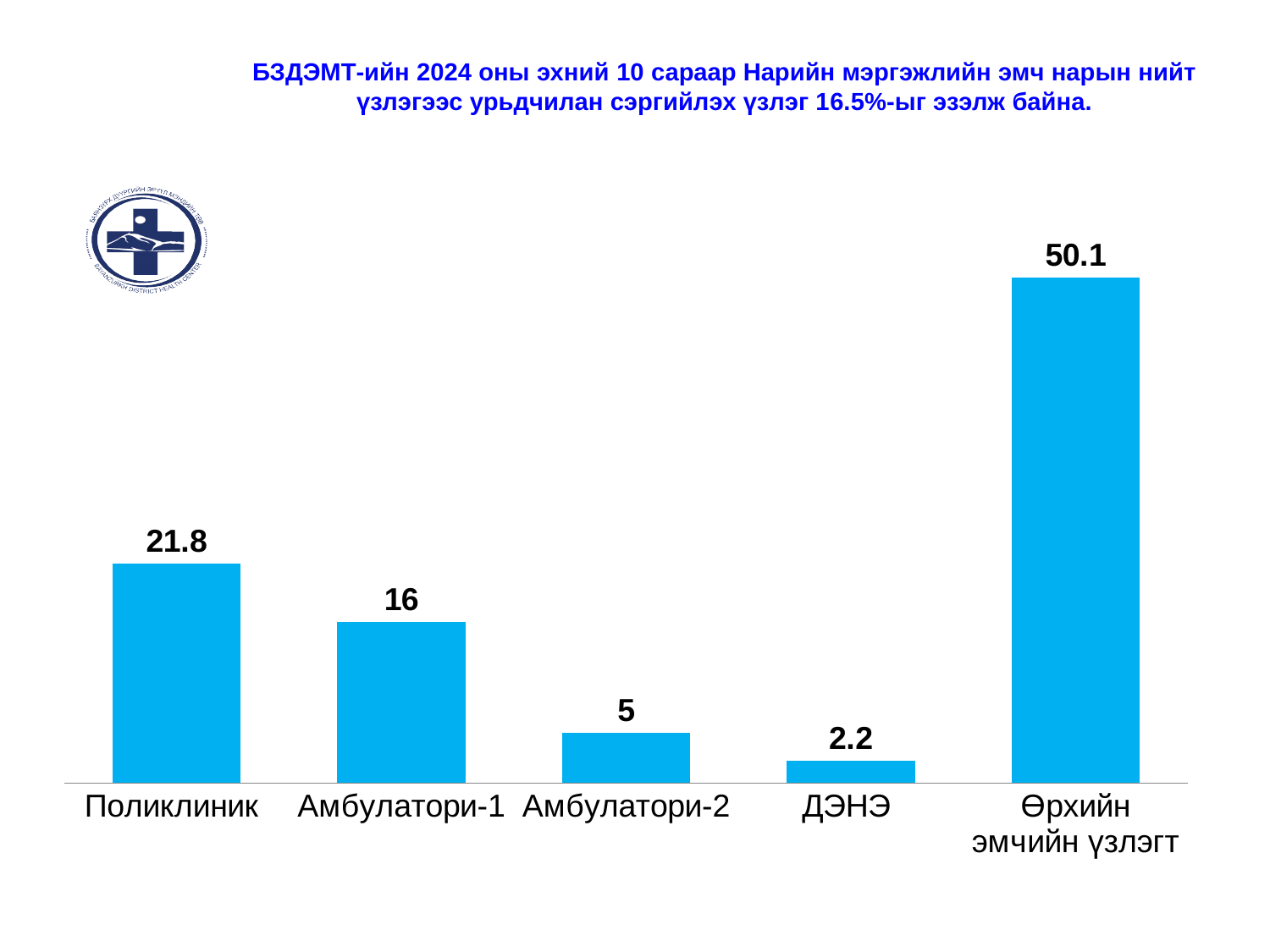
What kind of chart is shown on the slide? Bar chart What is the difference between the values for Өрхийн эмчийн үзлэгт and Поликлиник? 28.3 What is the difference between the values for Поликлиник and Амбулатори-1? 5.8 Which is larger, the value for Амбулатори-2 or the value for ДЭНЭ? Амбулатори-2 Which category has the lowest value? ДЭНЭ What is the value for Амбулатори-1? 16 Which category has the highest value? Өрхийн эмчийн үзлэгт What is the value for ДЭНЭ? 2.2 What is the value for Поликлиник? 21.8 What is the value for Өрхийн эмчийн үзлэгт? 50.1 What is the value for Амбулатори-2? 5 How many categories are shown in the chart? 5